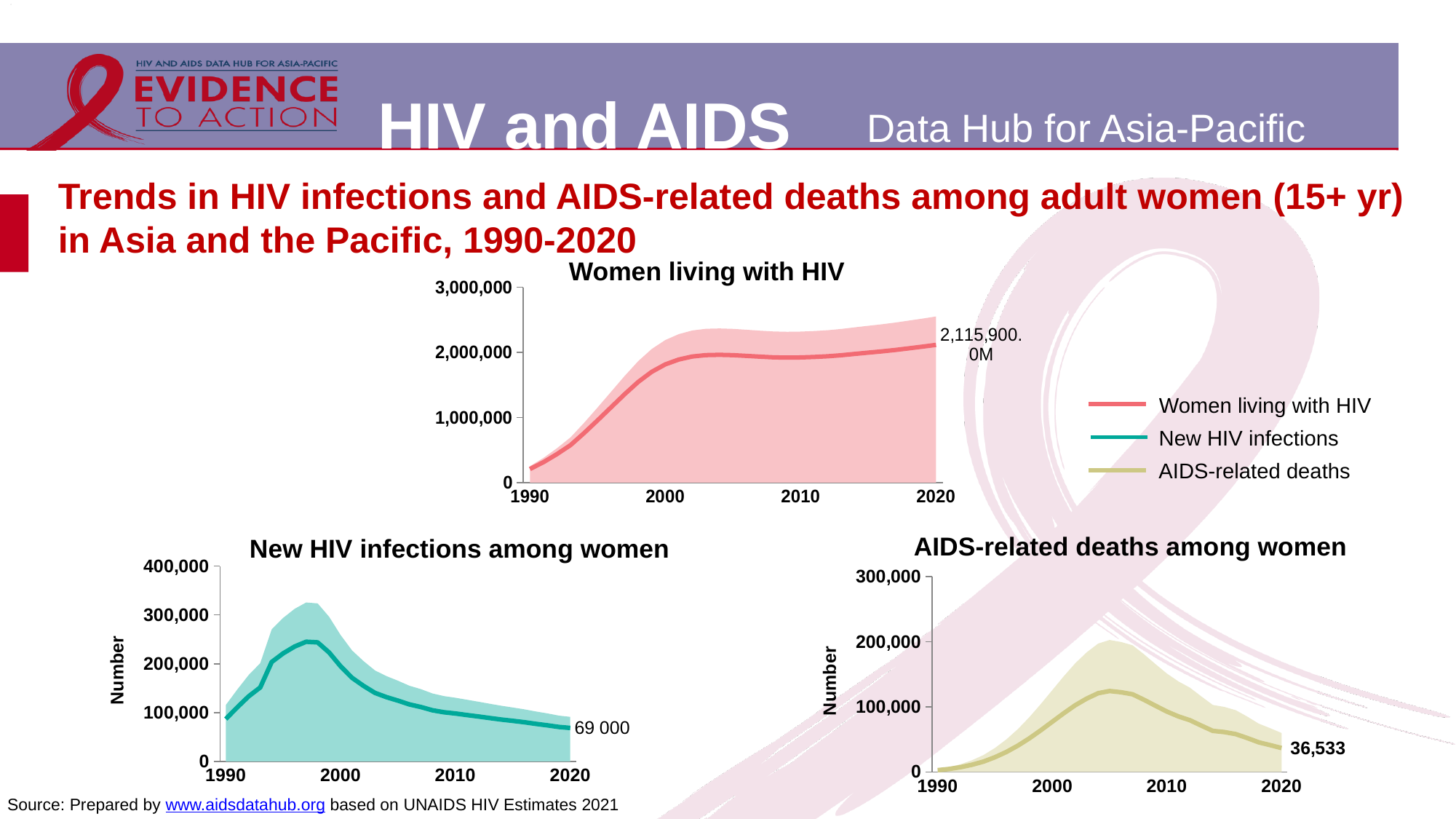
On the 'Women living with HIV' chart, what value is labelled for 2020? 2,115,900.0M What kind of chart is the 'New HIV infections among women' chart? Area and line chart (a line with a shaded range band) How many series does the legend on the slide list? 3 On the 'AIDS-related deaths among women' chart, what value is labelled for 2020? 36,533 On the 'AIDS-related deaths among women' chart, is the value for 2010 greater or less than 200,000? less Comparing the 2020 labels, which is larger: new HIV infections among women or AIDS-related deaths among women? New HIV infections among women On the 'New HIV infections among women' chart, what value is labelled for 2020? 69 000 On the 'Women living with HIV' chart, is the value for 2000 greater or less than 1,000,000? greater On the 'Women living with HIV' chart, do the values rise or fall from 1990 to 2000? rise On the 'New HIV infections among women' chart, do the values rise or fall from 2000 to 2020? fall On the 'New HIV infections among women' chart, is the value for 1990 greater or less than 200,000? less